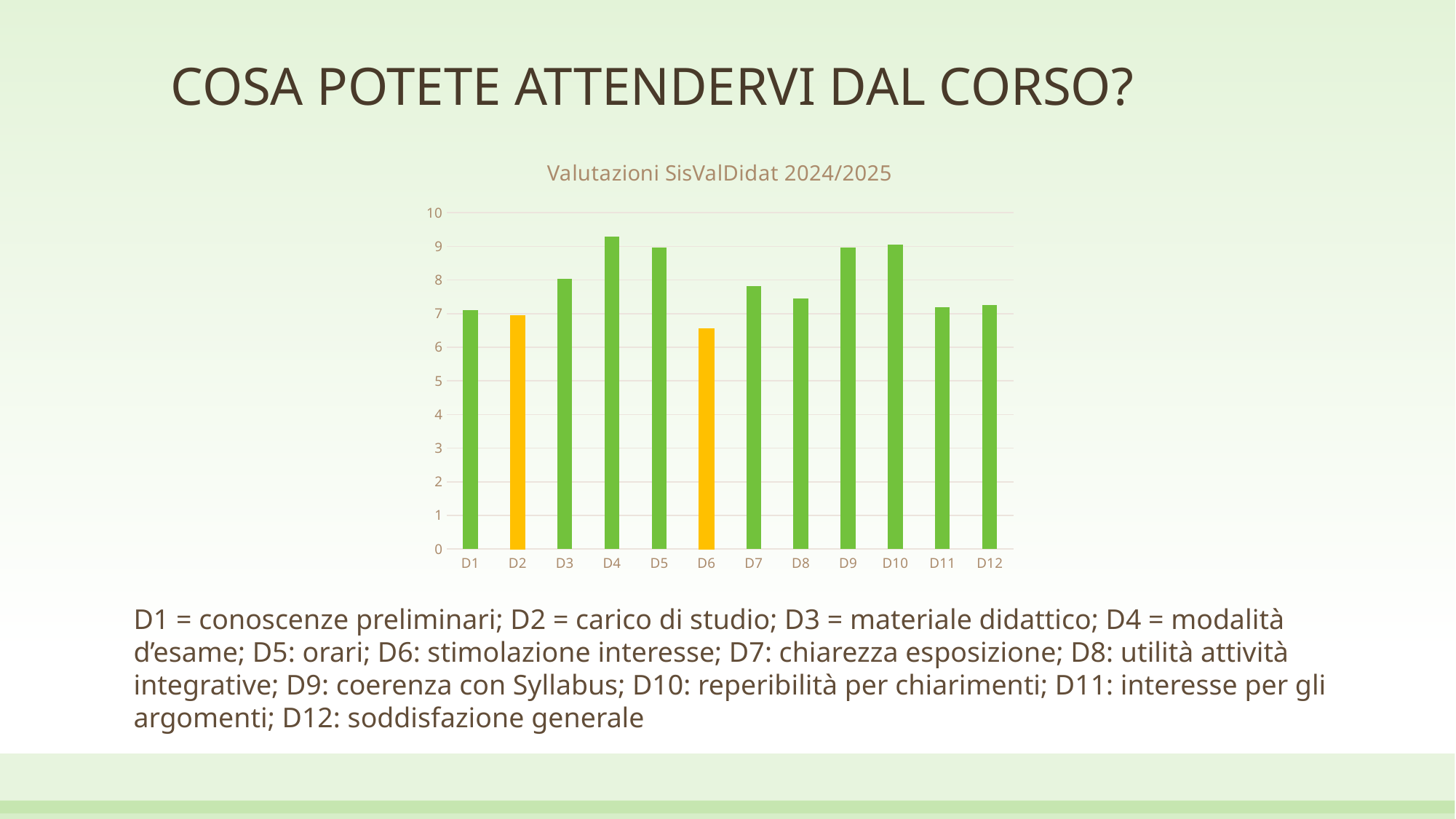
What is the title of the chart? Valutazioni SisValDidat 2024/2025 Which category has the lowest bar in the chart? D6 Which category has the highest bar in the chart? D4 Is the value for D6 greater or less than 7? less How many categories are plotted on the x axis of the chart? 12 Is the value for D7 greater or less than 8? less Is the value for D4 greater or less than 9? greater Which two categories are shown with orange bars instead of green? D2 and D6 What kind of chart is shown on the slide? Bar chart Which is larger, the value for D3 or the value for D8? D3 Which is larger, the value for D7 or the value for D11? D7